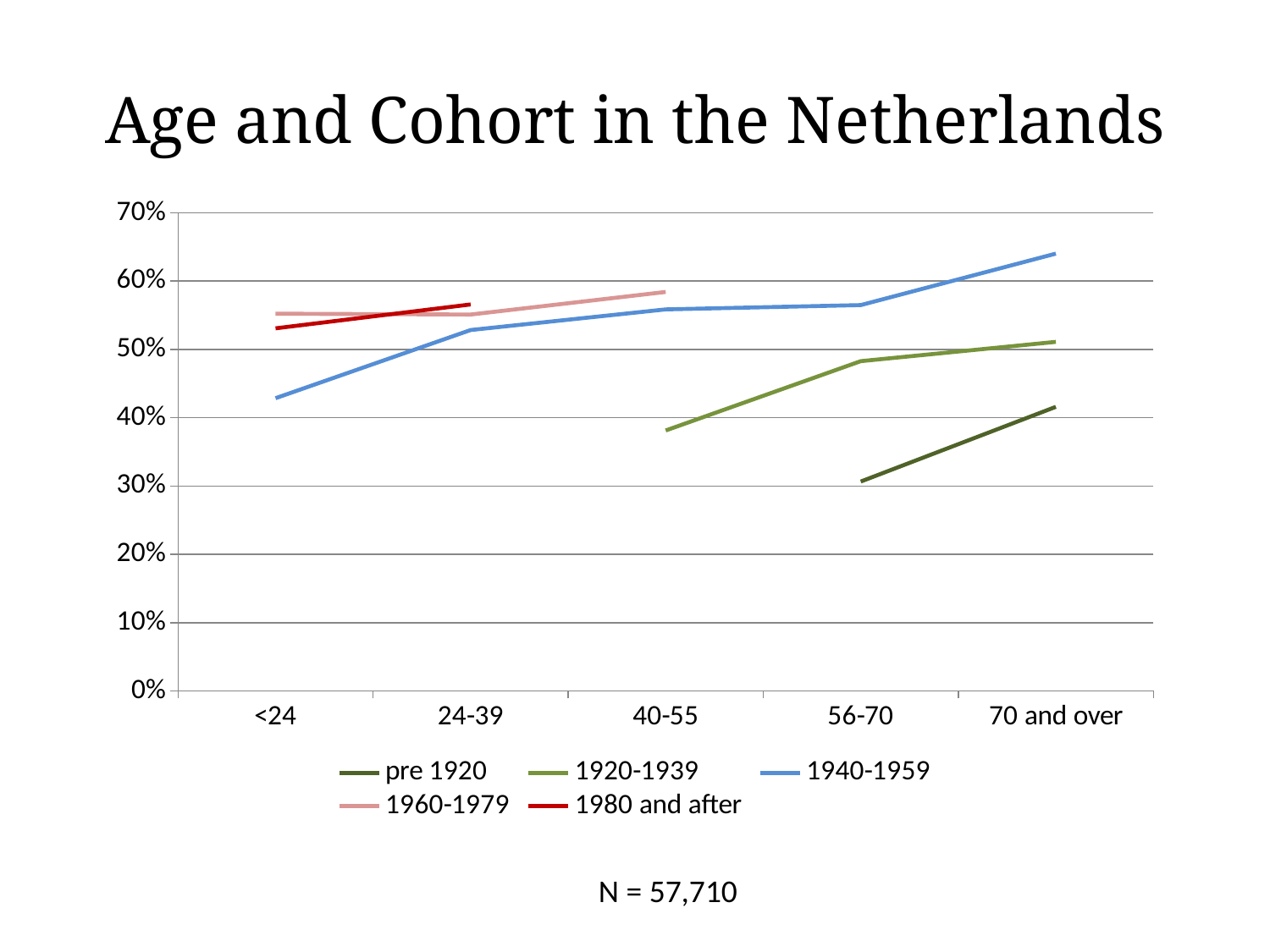
How many series does the legend list? 5 How many age categories are shown on the x axis? 5 Is the value for the 1920-1939 cohort at age 40-55 greater or less than 50%? less What kind of chart is shown on the slide? line chart Is the value for the pre 1920 cohort at age 56-70 greater or less than 40%? less Which cohort has the highest value at age 70 and over? 1940-1959 What sample size (N) is stated below the chart? N = 57,710 Which cohort has the lowest value at age 56-70? pre 1920 Is the value for the 1940-1959 cohort at age <24 greater or less than 40%? greater Does the 1940-1959 line rise or fall from age <24 to age 70 and over? rise What is the title of the chart? Age and Cohort in the Netherlands